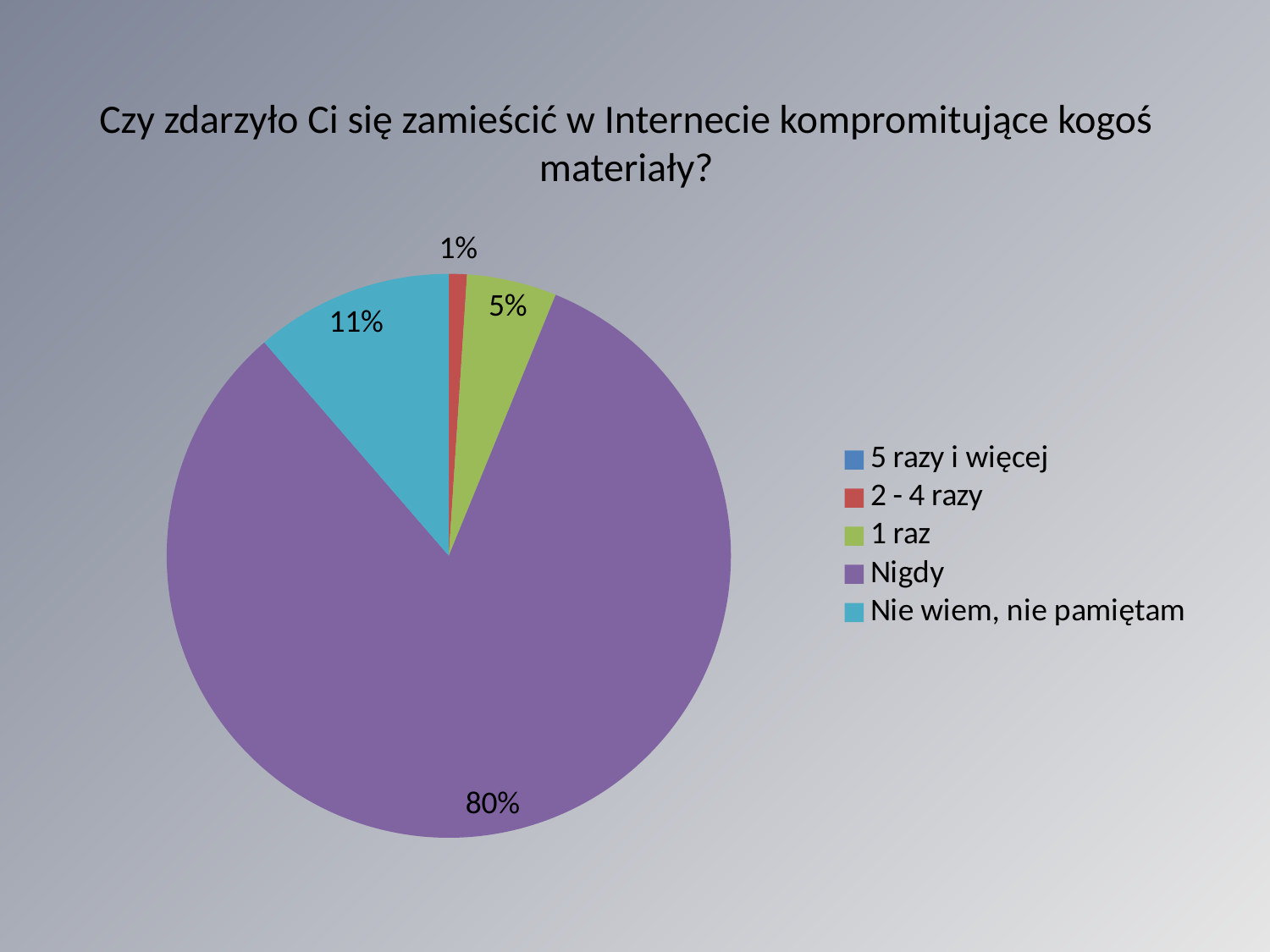
What kind of chart is shown on the slide? pie chart Which category has the largest slice of the pie? Nigdy What percentage is shown for "2 - 4 razy"? 1% How many entries does the legend list? 5 What percentage is shown for "Nie wiem, nie pamiętam"? 11% What is the title of the chart? Czy zdarzyło Ci się zamieścić w Internecie kompromitujące kogoś materiały? What percentage is shown for "1 raz"? 5% What colour is the slice for "Nigdy"? purple What is the difference in percentage points between "Nigdy" and "Nie wiem, nie pamiętam"? 69% Which is larger, the slice for "1 raz" or the slice for "Nie wiem, nie pamiętam"? Nie wiem, nie pamiętam What percentage of the pie is labelled for "Nigdy"? 80% What share of the pie does "Nigdy" take? 80%